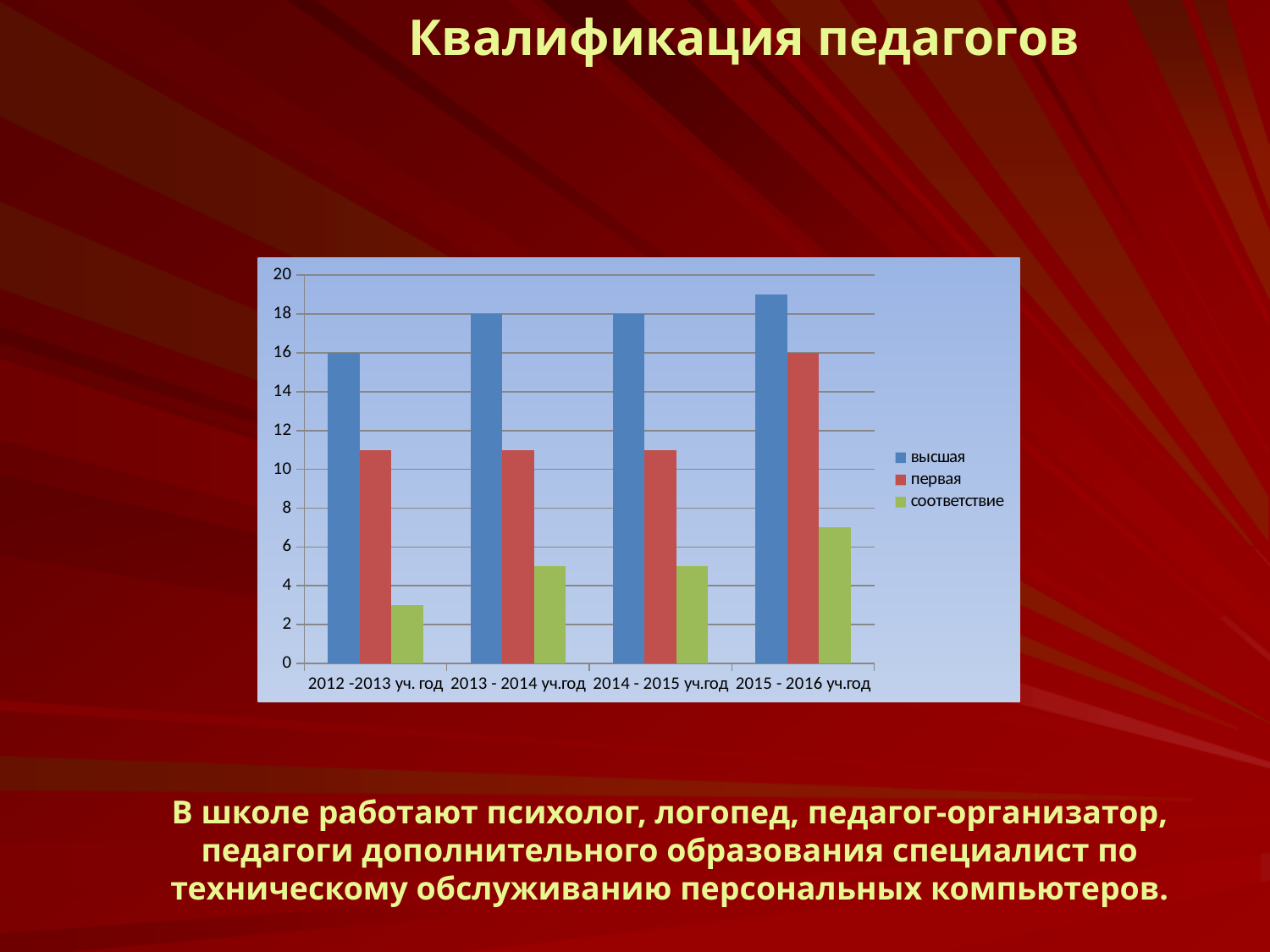
What is the value of the высшая series for 2013 - 2014 уч.год? 18 How many school years are shown on the x axis? 4 In 2012 -2013 уч. год, which is larger: высшая or первая? высшая Is the value for соответствие in 2012 -2013 уч. год greater or less than 4? less Which school year has the highest value for the высшая series? 2015 - 2016 уч.год How many series does the legend list? 3 Which school year has the lowest value for the соответствие series? 2012 -2013 уч. год What is the value of the высшая series for 2012 -2013 уч. год? 16 Does the соответствие series rise or fall from 2012 -2013 уч. год to 2015 - 2016 уч.год? rise What is the difference between the высшая values for 2013 - 2014 уч.год and 2012 -2013 уч. год? 2 What is the value of the первая series for 2015 - 2016 уч.год? 16 Is the value for высшая in 2015 - 2016 уч.год greater or less than 18? greater